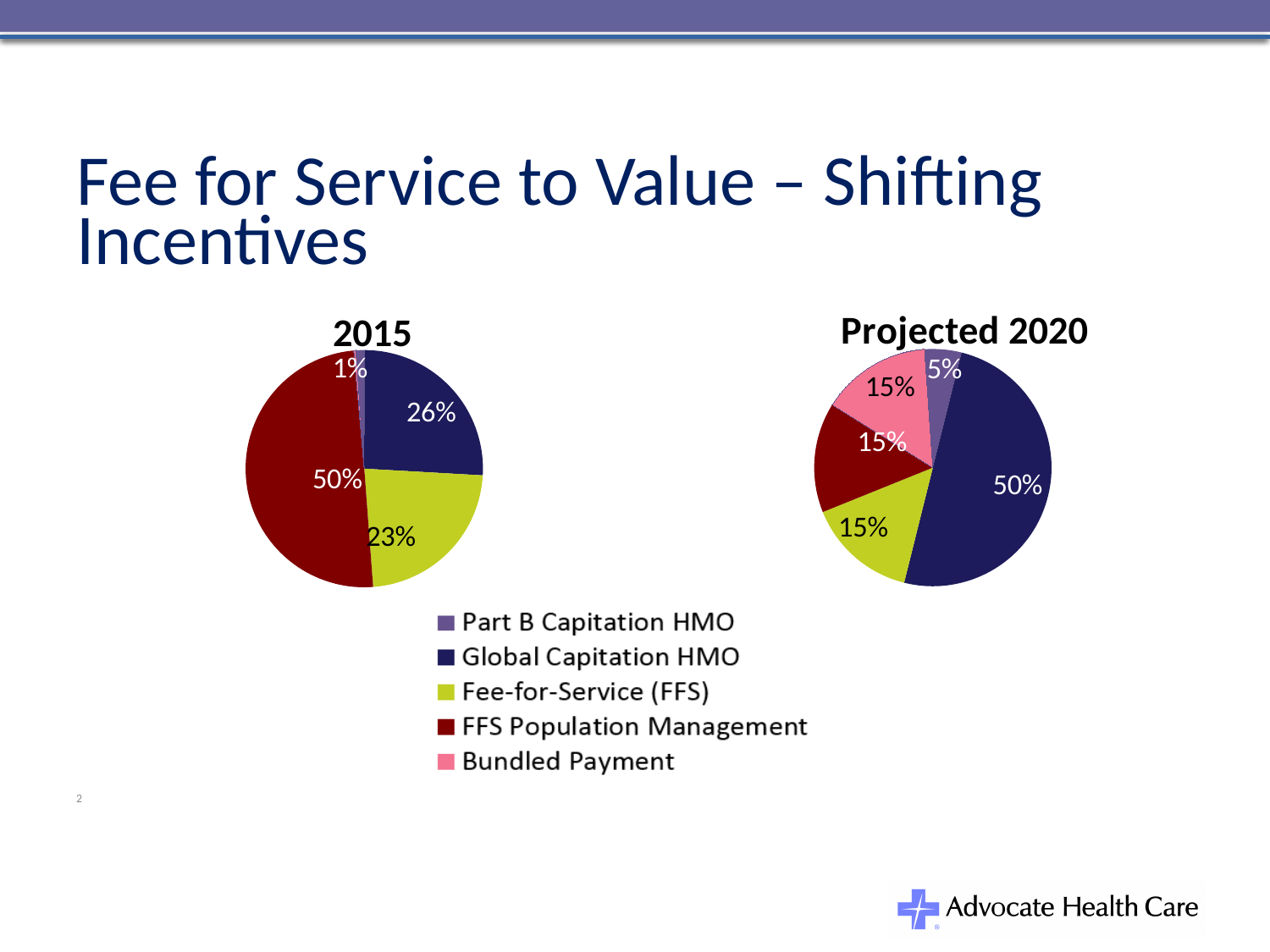
In the Projected 2020 pie chart, which category has the smallest share? Part B Capitation HMO In the 2015 pie chart, which is larger: Global Capitation HMO or Fee-for-Service (FFS)? Global Capitation HMO How many series does the legend list? 5 What is the difference between the Global Capitation HMO share in the Projected 2020 chart and in the 2015 chart? 24% In the Projected 2020 pie chart, what share does Global Capitation HMO have? 50% In the Projected 2020 pie chart, what share does Part B Capitation HMO have? 5% In the 2015 pie chart, what share does FFS Population Management have? 50% In the 2015 pie chart, what share does Fee-for-Service (FFS) have? 23% In the 2015 pie chart, what share does Part B Capitation HMO have? 1% In the 2015 pie chart, what share does Global Capitation HMO have? 26% In the 2015 pie chart, which category has the largest share? FFS Population Management In the Projected 2020 pie chart, what share does Bundled Payment have? 15%